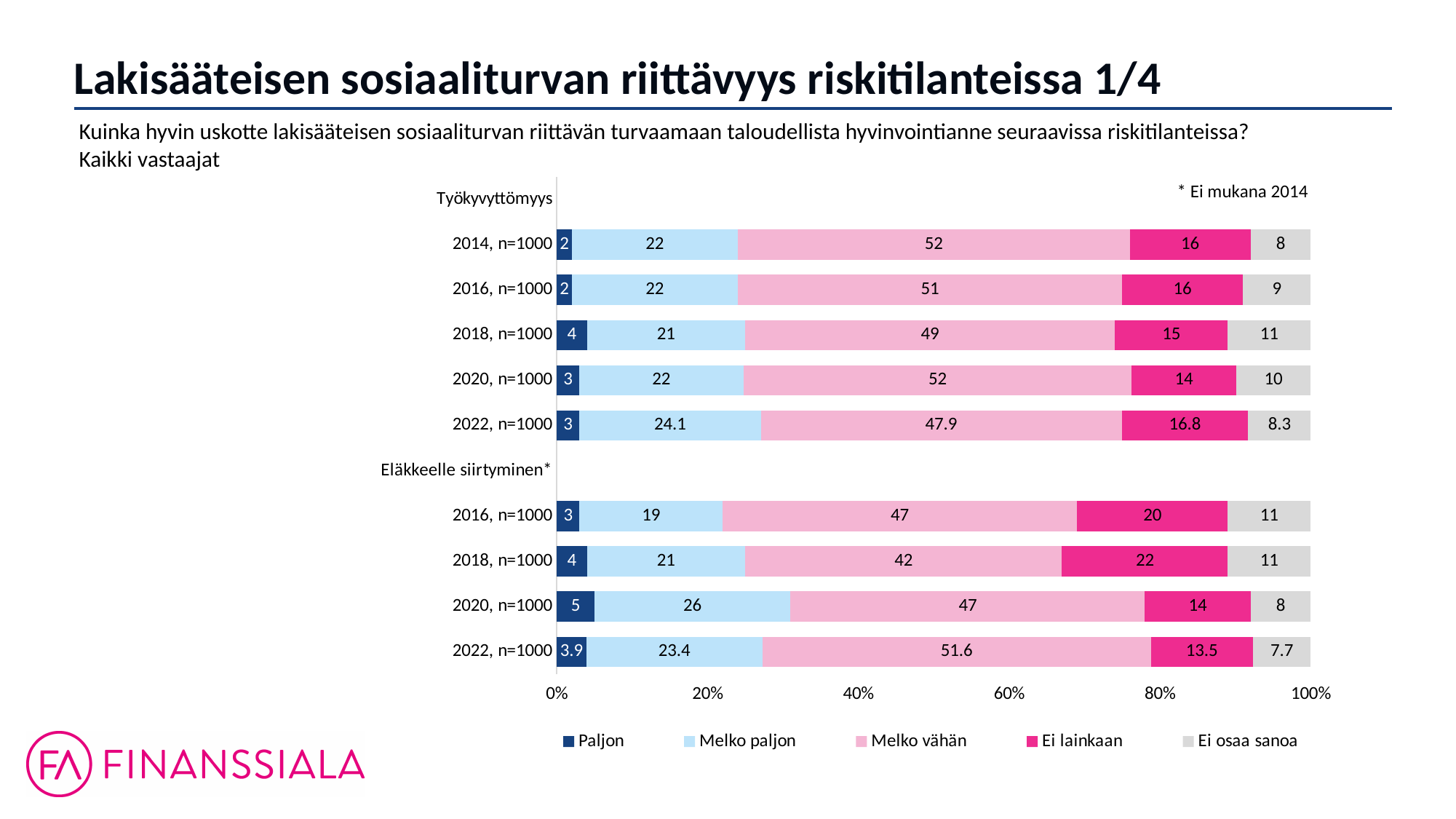
Which is larger: the "Melko paljon" value for Eläkkeelle siirtyminen 2016, n=1000 or for Eläkkeelle siirtyminen 2020, n=1000? Eläkkeelle siirtyminen 2020, n=1000 Which bar has the highest "Paljon" value? Eläkkeelle siirtyminen 2020, n=1000 What is the value of "Ei lainkaan" for Eläkkeelle siirtyminen 2018, n=1000? 22 What is the difference between the "Ei lainkaan" values for Eläkkeelle siirtyminen 2018, n=1000 and Eläkkeelle siirtyminen 2020, n=1000? 8 How many series does the legend list? 5 What is the value of "Melko paljon" for Työkyvyttömyys 2022, n=1000? 24.1 What kind of chart is shown on the slide? Stacked bar chart What is the value of "Ei osaa sanoa" for Eläkkeelle siirtyminen 2022, n=1000? 7.7 What is the total of the Työkyvyttömyys 2018, n=1000 bar? 100 What is the value of "Melko vähän" for Työkyvyttömyys 2014, n=1000? 52 How many bars are plotted in the chart? 9 Which bar has the lowest "Melko vähän" value? Eläkkeelle siirtyminen 2018, n=1000